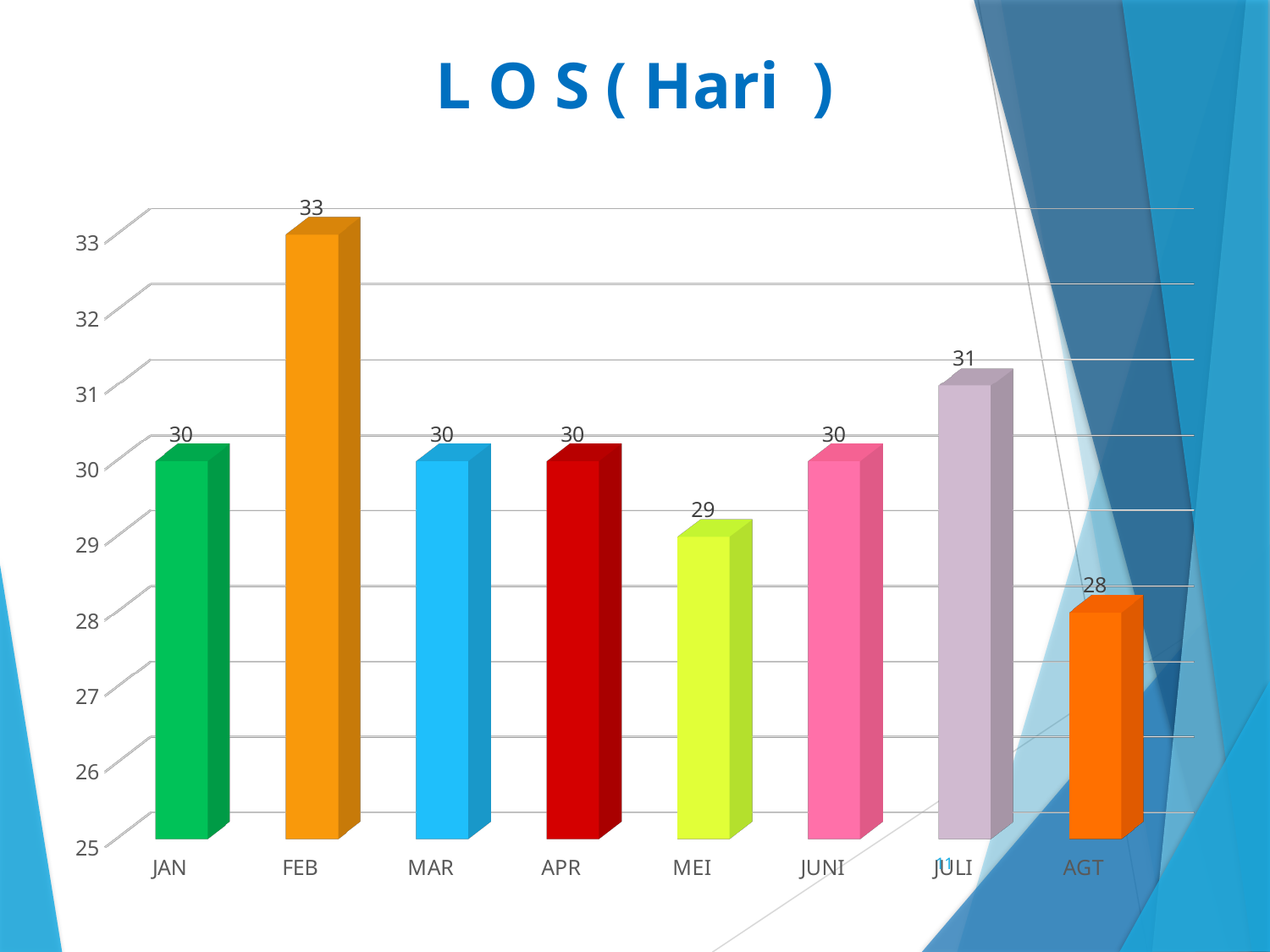
What is the value for JULI? 31 What kind of chart is shown? bar chart What is the value for AGT? 28 Which is larger, the value for JULI or the value for MEI? JULI Which month has the lowest value? AGT What is the value for FEB? 33 What is the value for MEI? 29 What colour is the bar for JAN? green Which month has the highest value? FEB What is the difference between the values for FEB and AGT? 5 How many months are shown on the x axis? 8 What is the title of the chart? L O S ( Hari )